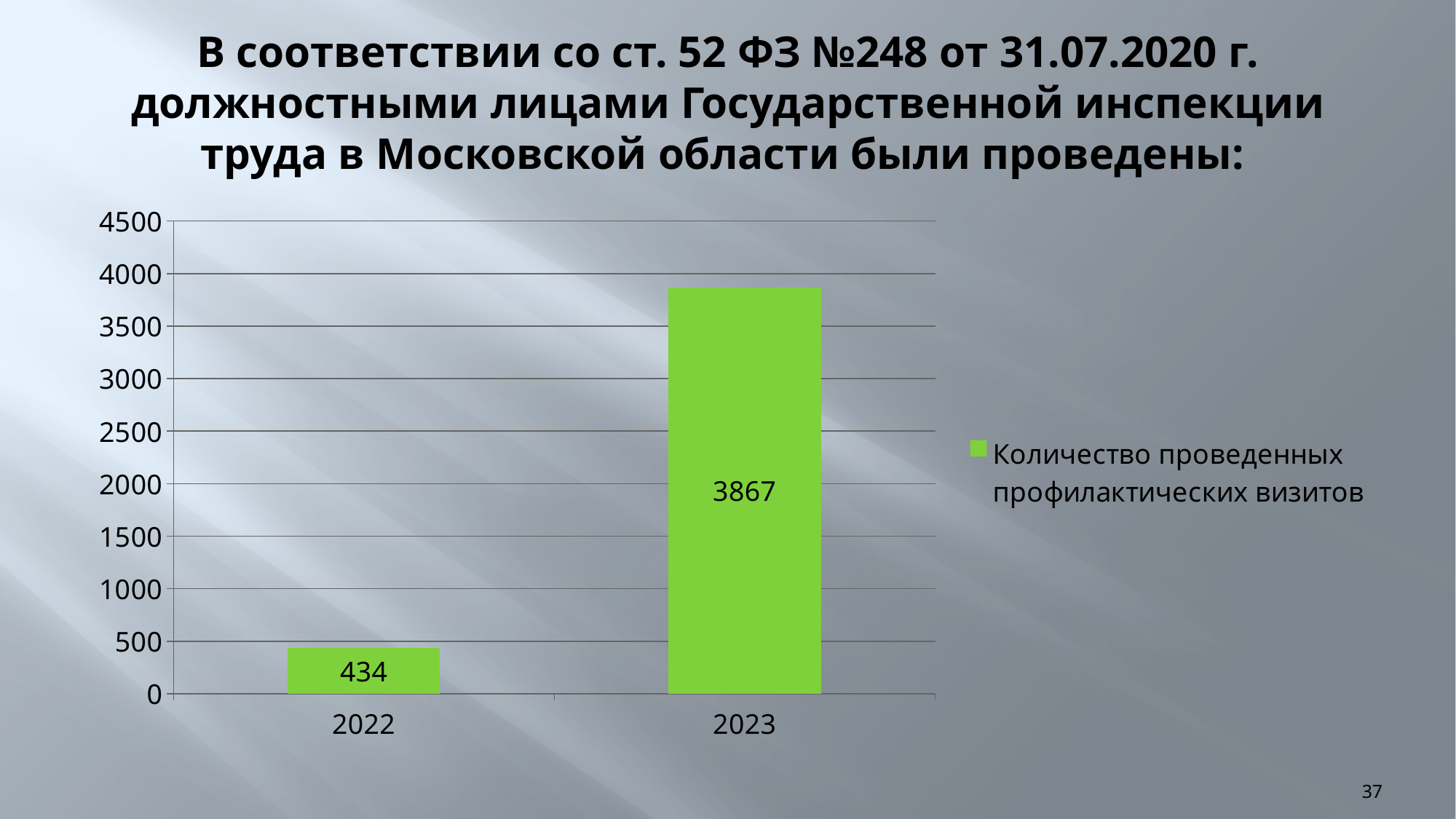
Which year has the lower number of preventive visits? 2022 How many series does the legend list? 1 By how much did the number of preventive visits in 2023 exceed that of 2022? 3433 Is the value for 2023 greater or less than 3500? greater What is the number of preventive visits conducted in 2023? 3867 How many years are shown on the x axis of the chart? 2 What is the number of preventive visits conducted in 2022? 434 Do the values rise or fall from 2022 to 2023? Rise Is the value for 2022 greater or less than 500? less What is the legend entry for the series shown in the chart? Количество проведенных профилактических визитов Which year has the higher number of preventive visits? 2023 What kind of chart is shown on the slide? Bar chart